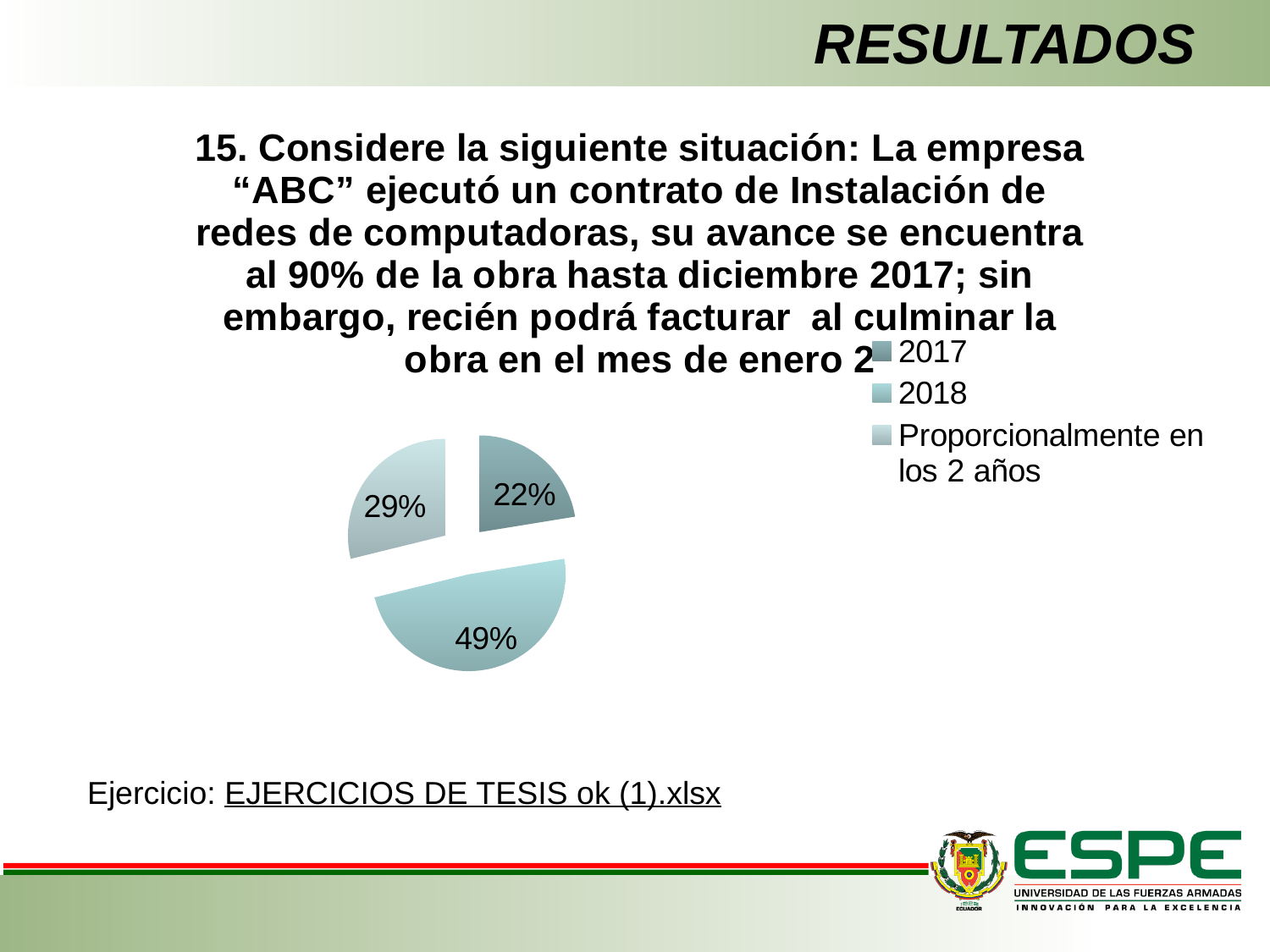
What percentage of the pie corresponds to 2017? 22% What is the difference in percentage points between the 'Proporcionalmente en los 2 años' slice and the 2017 slice? 7 Which category has the largest share of the pie? 2018 What percentage of the pie corresponds to 2018? 49% Which is larger, the share for 2017 or the share for 'Proporcionalmente en los 2 años'? Proporcionalmente en los 2 años Which category has the smallest share of the pie? 2017 What kind of chart is shown on the slide? pie chart How many entries does the legend list? 3 What is the difference in percentage points between the 2018 slice and the 2017 slice? 27 How many slices does the pie chart have? 3 What percentage of the pie corresponds to 'Proporcionalmente en los 2 años'? 29% What is the third entry listed in the legend? Proporcionalmente en los 2 años